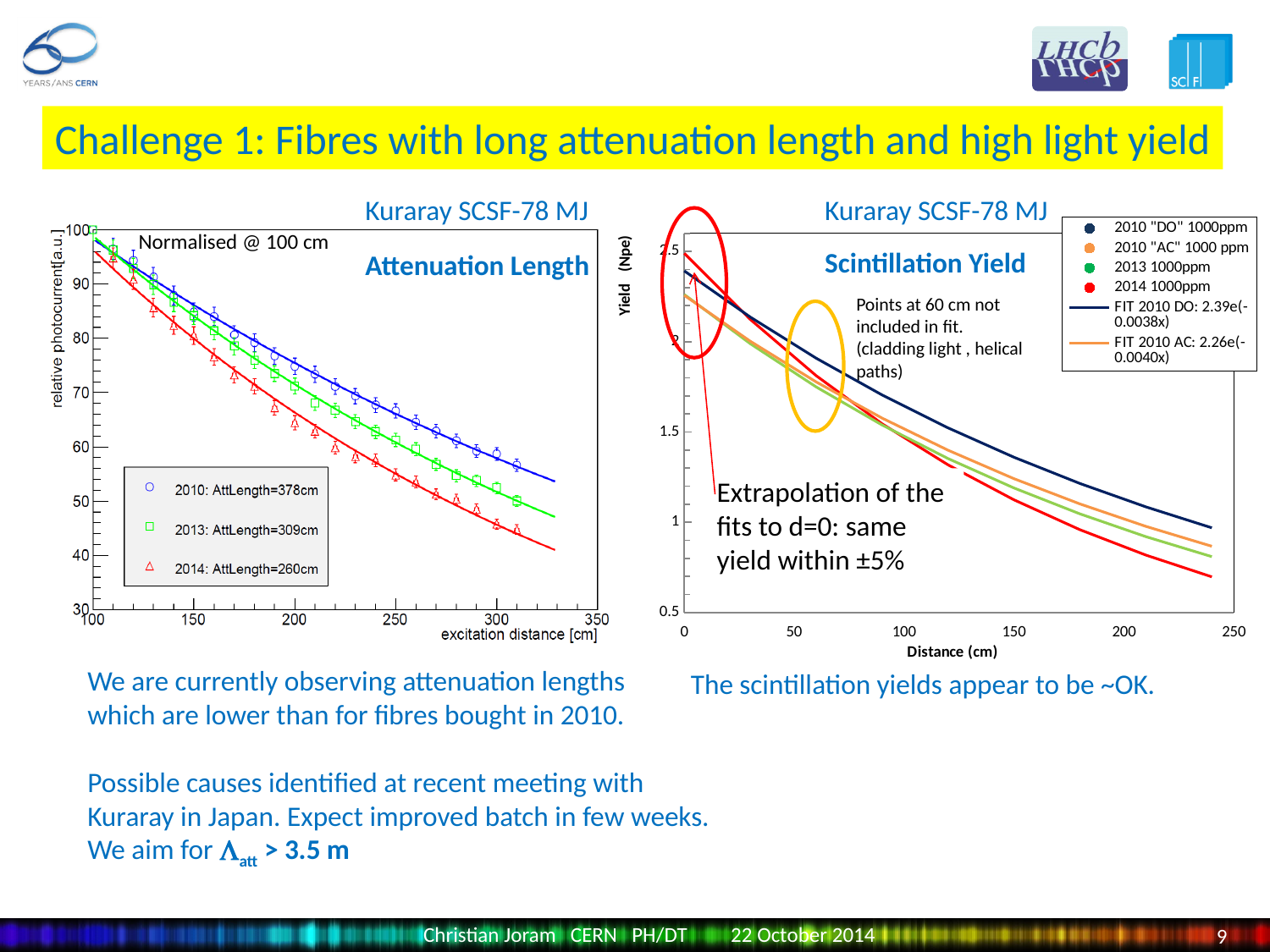
In the Attenuation Length chart, what is the difference between the 2010 and 2014 attenuation lengths? 118cm In the Attenuation Length chart, how many data series are shown in the legend? 3 In the Attenuation Length chart, what attenuation length is given in the legend for the 2014 fibres? 260cm In the Scintillation Yield chart, is the 2014 yield at 240 cm greater or less than 1? less In the Attenuation Length chart, what attenuation length is given in the legend for the 2010 fibres? 378cm In the Attenuation Length chart, is the 2013 attenuation length larger or smaller than the 2010 attenuation length? smaller In the Attenuation Length chart, which year's fibres have the longest attenuation length? 2010 In the Attenuation Length chart, does the relative photocurrent rise or fall as the excitation distance increases? fall In the Attenuation Length chart, is the 2014 relative photocurrent at 300 cm greater or less than 50? less In the Attenuation Length chart, which year's fibres have the shortest attenuation length? 2014 In the Scintillation Yield chart, what fit function is given for the 2010 DO data? 2.39e(-0.0038x) In the Scintillation Yield chart, how many entries does the legend list? 6